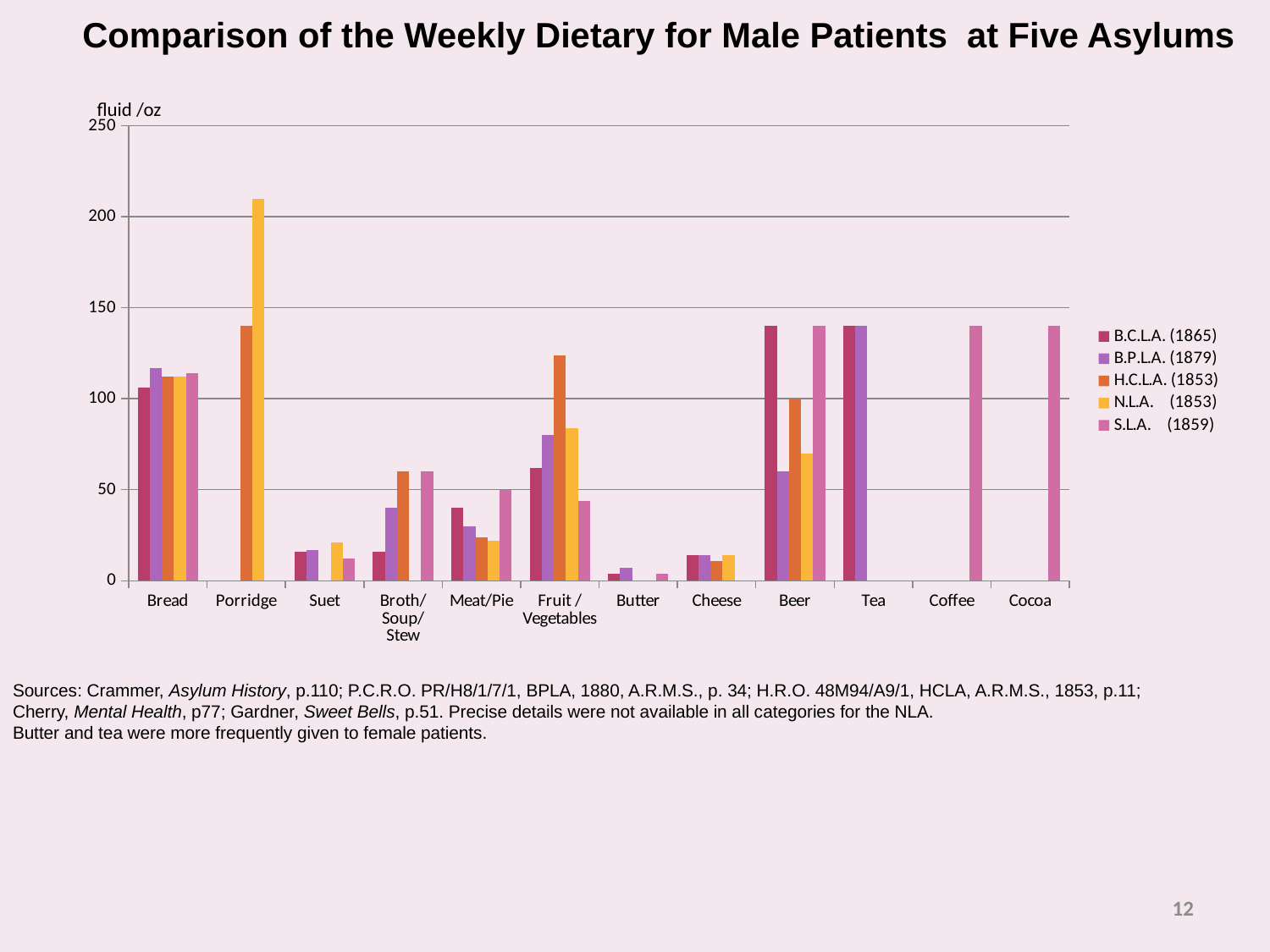
How many food and drink categories are shown on the x axis? 12 Which asylum is the only one with a bar shown for Coffee? S.L.A. (1859) Which is larger for Beer: the B.C.L.A. (1865) value or the B.P.L.A. (1879) value? B.C.L.A. (1865) What kind of chart is shown on the slide? bar chart Is the H.C.L.A. (1853) value for Fruit / Vegetables greater or less than 100? greater Is the B.P.L.A. (1879) value for Bread greater or less than 100? greater How many series does the legend list? 5 Is the N.L.A. (1853) value for Porridge greater or less than 200? greater What unit is shown on the y axis of the chart? fluid /oz Which category contains the tallest bar in the chart? Porridge Which asylum has the tallest bar for Porridge? N.L.A. (1853)